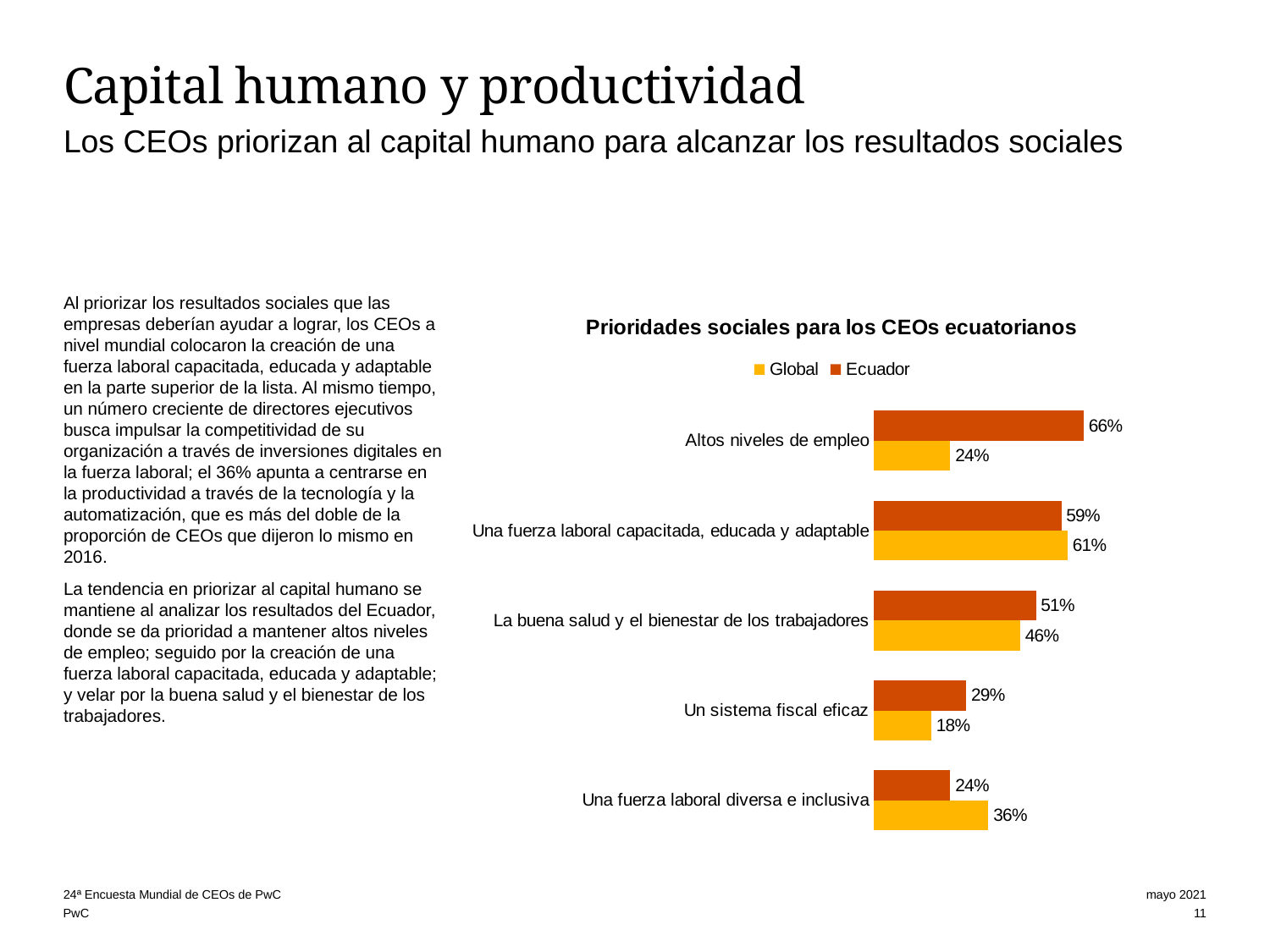
What is the difference between the Ecuador and Global values for "Altos niveles de empleo"? 42% What is the Global value for "Una fuerza laboral diversa e inclusiva"? 36% Which category has the lowest Global value? Un sistema fiscal eficaz How many series does the legend list? 2 What is the Global value for "Un sistema fiscal eficaz"? 18% How many categories are shown in the chart? 5 For "Una fuerza laboral capacitada, educada y adaptable", which is larger, the Global value or the Ecuador value? Global What is the difference between the Global and Ecuador values for "Una fuerza laboral diversa e inclusiva"? 12% Which category has the highest Ecuador value? Altos niveles de empleo What is the Ecuador value for "Altos niveles de empleo"? 66% What kind of chart is shown on the slide? Bar chart For "La buena salud y el bienestar de los trabajadores", which is larger, the Ecuador value or the Global value? Ecuador